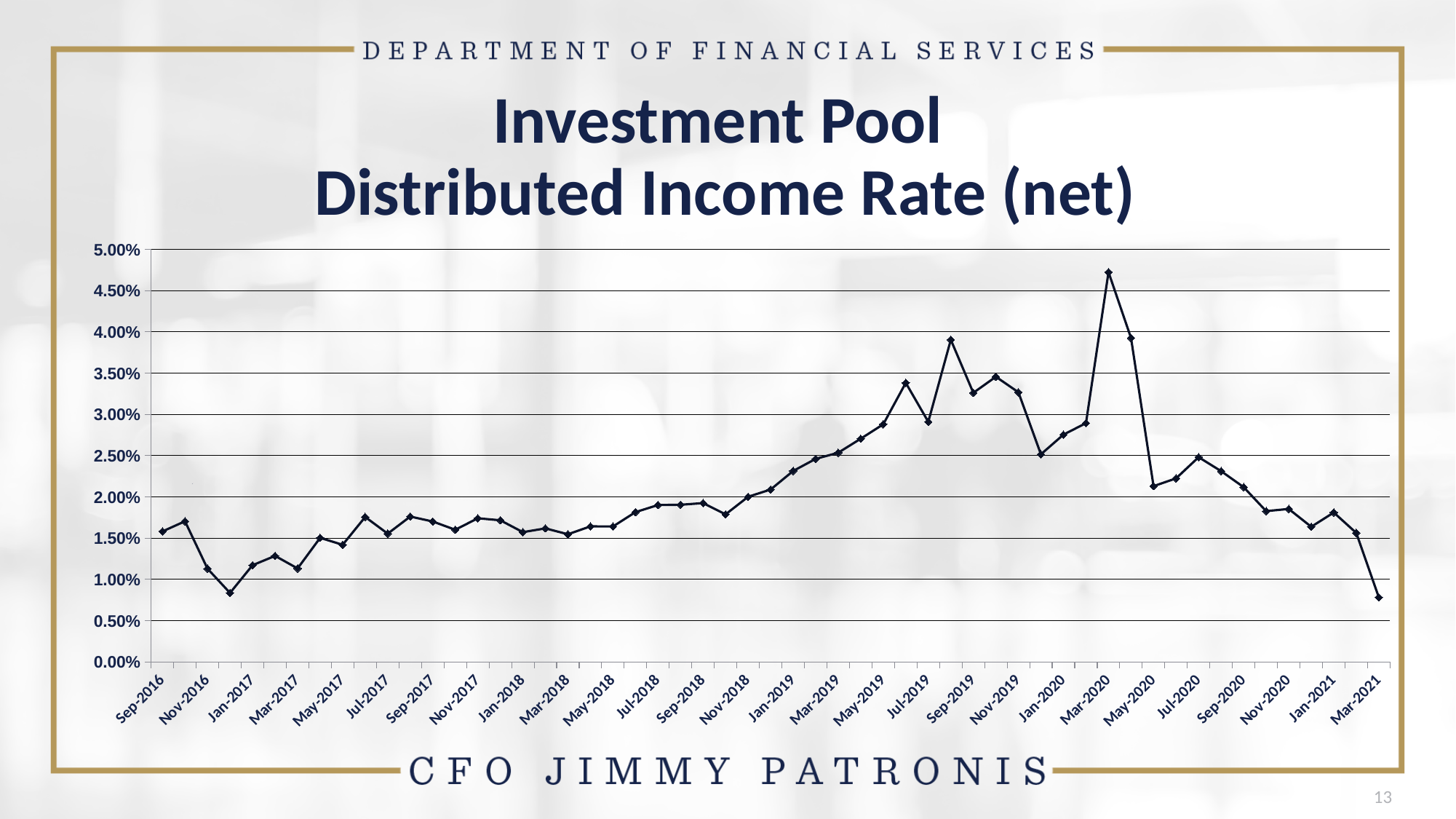
Which is larger, the value for Sep-2016 or the value for Sep-2019? Sep-2019 Does the distributed income rate rise or fall between Mar-2020 and Mar-2021? fall Is the value for Nov-2020 greater or less than 2.00%? less What is the title of the chart? Investment Pool Distributed Income Rate (net) Is the value for Mar-2021 greater or less than 1.00%? less What kind of chart is shown on the slide? line chart What is the highest value shown on the y axis? 5.00% Is the value for Sep-2019 greater or less than 3.00%? greater Which is larger, the value for Mar-2020 or the value for Mar-2021? Mar-2020 In which labeled month does the distributed income rate reach its highest point? Mar-2020